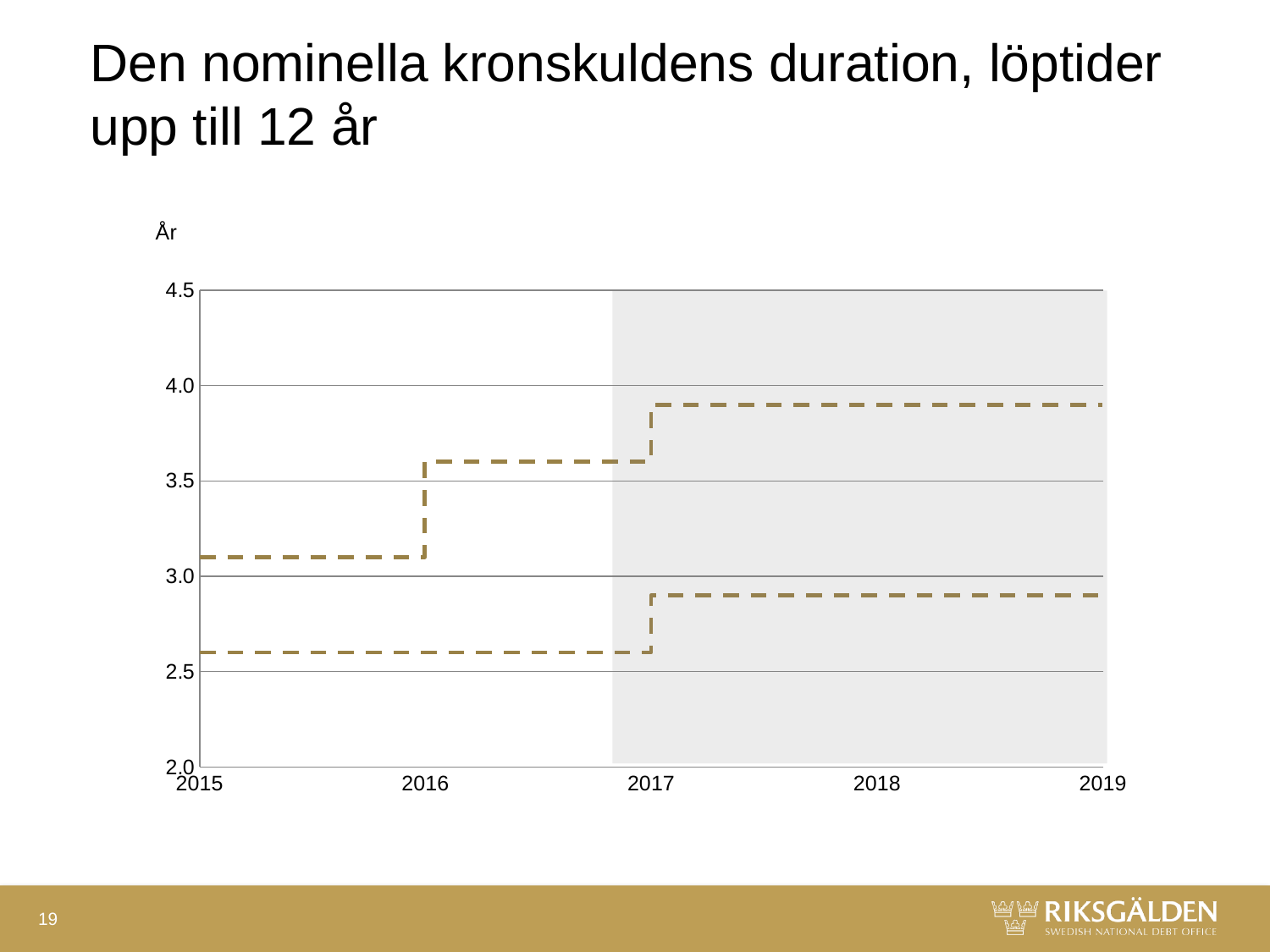
Is the value of the upper dashed line at the start of 2015 greater or less than 3.5? less How many years are labelled on the x axis of the chart? 5 What kind of chart is shown on the slide? line chart Does the lower dashed line rise or fall from 2015 to 2019? rise How many dashed lines are plotted on the chart? 2 Is the value of the lower dashed line in 2015 greater or less than 3.0? less What label is shown on the vertical axis of the chart? År What is the title of the chart on the slide? Den nominella kronskuldens duration, löptider upp till 12 år Is the value of the upper dashed line in 2018 greater or less than 3.5? greater Does the upper dashed line rise or fall from 2015 to 2019? rise